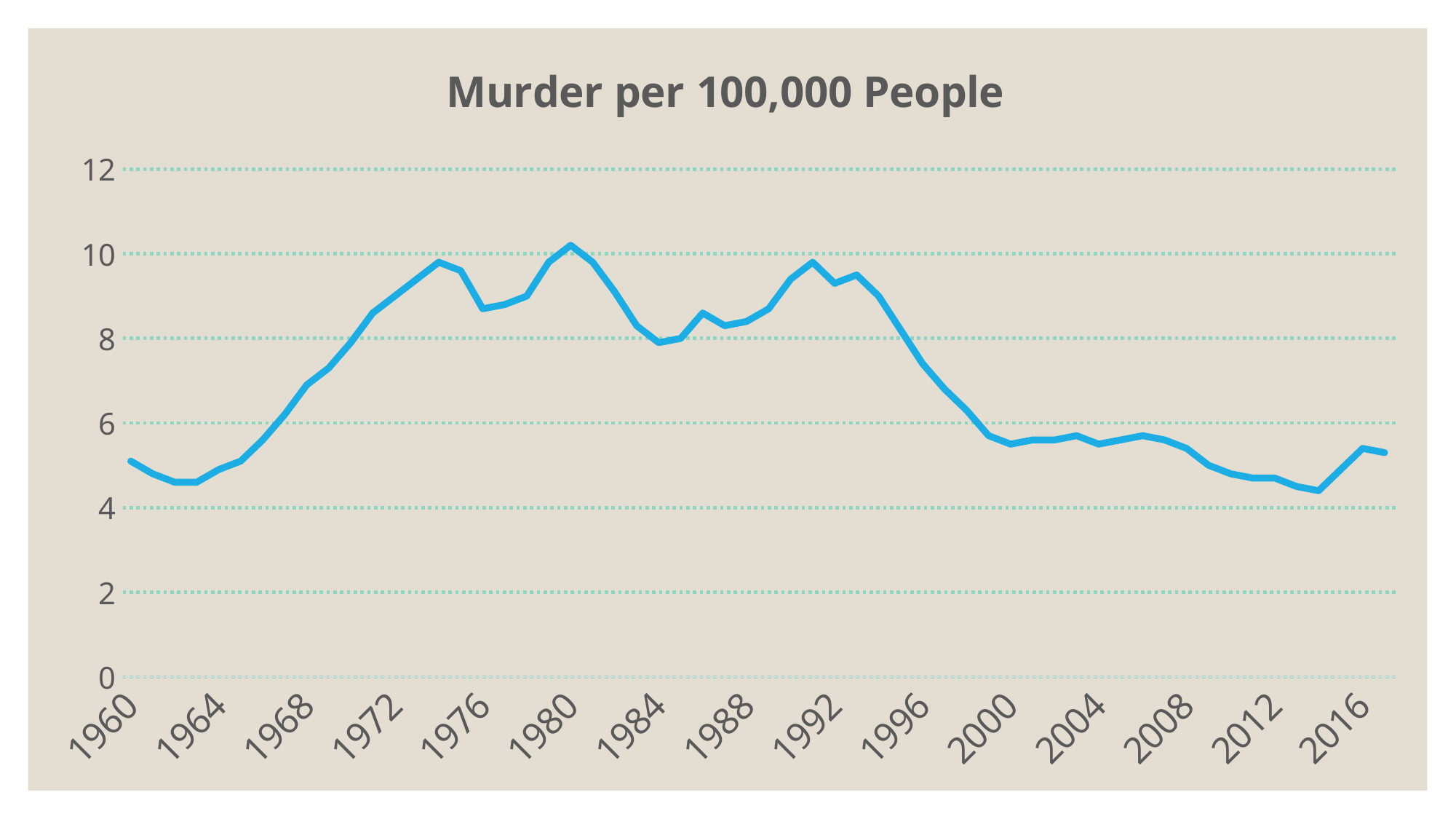
Does the murder rate rise or fall between 1960 and 1980? rise Which year has the higher murder rate, 1980 or 2000? 1980 Is the value for 1960 greater or less than 6? less Is the value for 1968 greater or less than 6? greater What is the title of the chart? Murder per 100,000 People What kind of chart is shown on the slide? line chart Is the value for 1996 greater or less than 8? less Does the murder rate rise or fall between 1992 and 2000? fall In which year shown on the x axis does the murder rate reach its highest point? 1980 How many year labels are shown on the x axis? 15